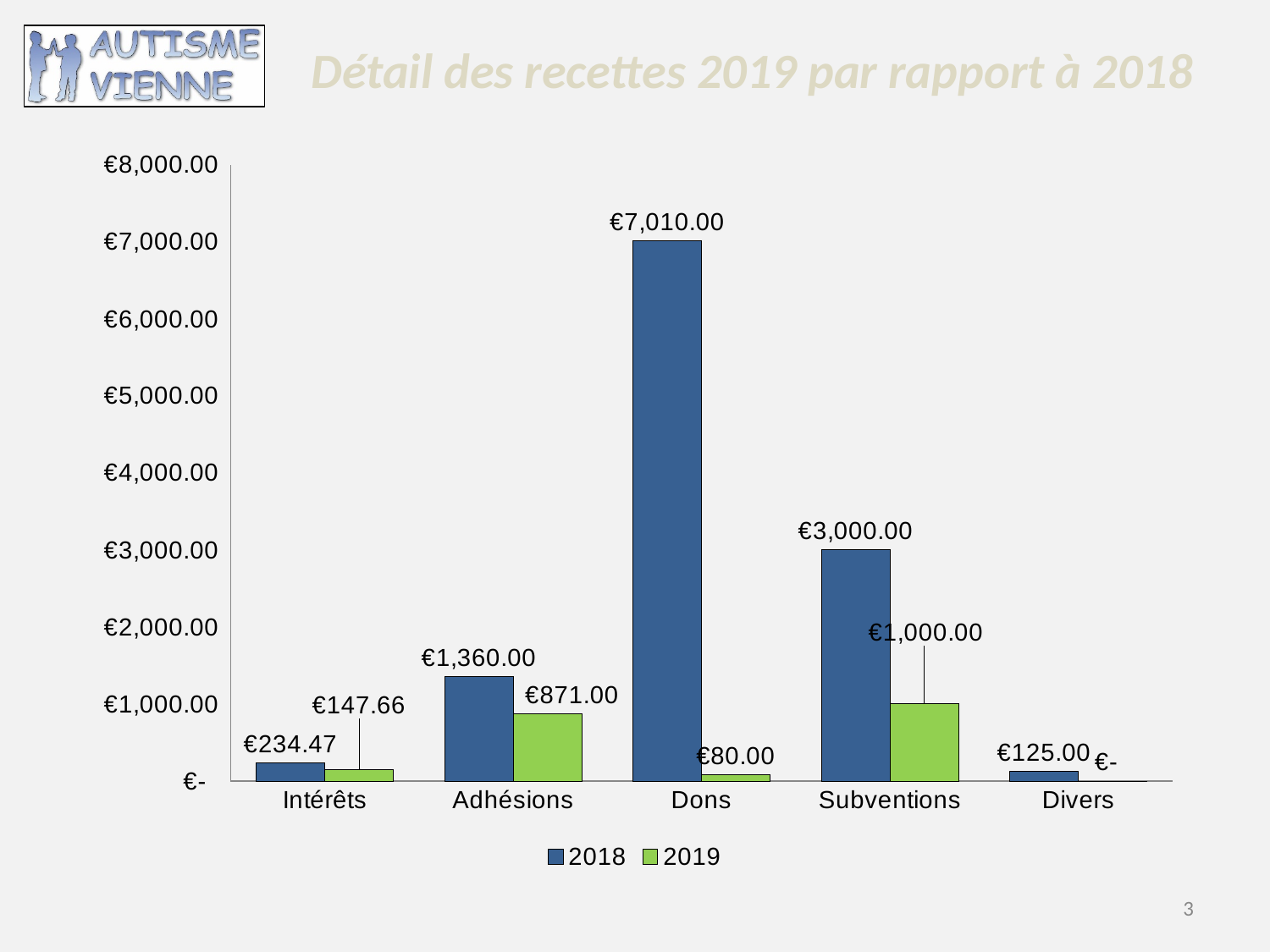
What is the 2018 value for Dons? €7,010.00 What is the 2019 value for Adhésions? €871.00 How many series does the legend list? 2 What is the difference between the 2018 and 2019 values for Subventions? €2,000.00 Which is larger for Adhésions, the 2018 value or the 2019 value? 2018 Which category has the highest 2018 value? Dons What is the difference between the 2018 and 2019 values for Dons? €6,930.00 What is the 2018 value for Divers? €125.00 What is the 2019 value for Intérêts? €147.66 Which category has the lowest 2019 value? Divers How many categories are shown on the x axis? 5 What kind of chart is shown on the slide? Bar chart